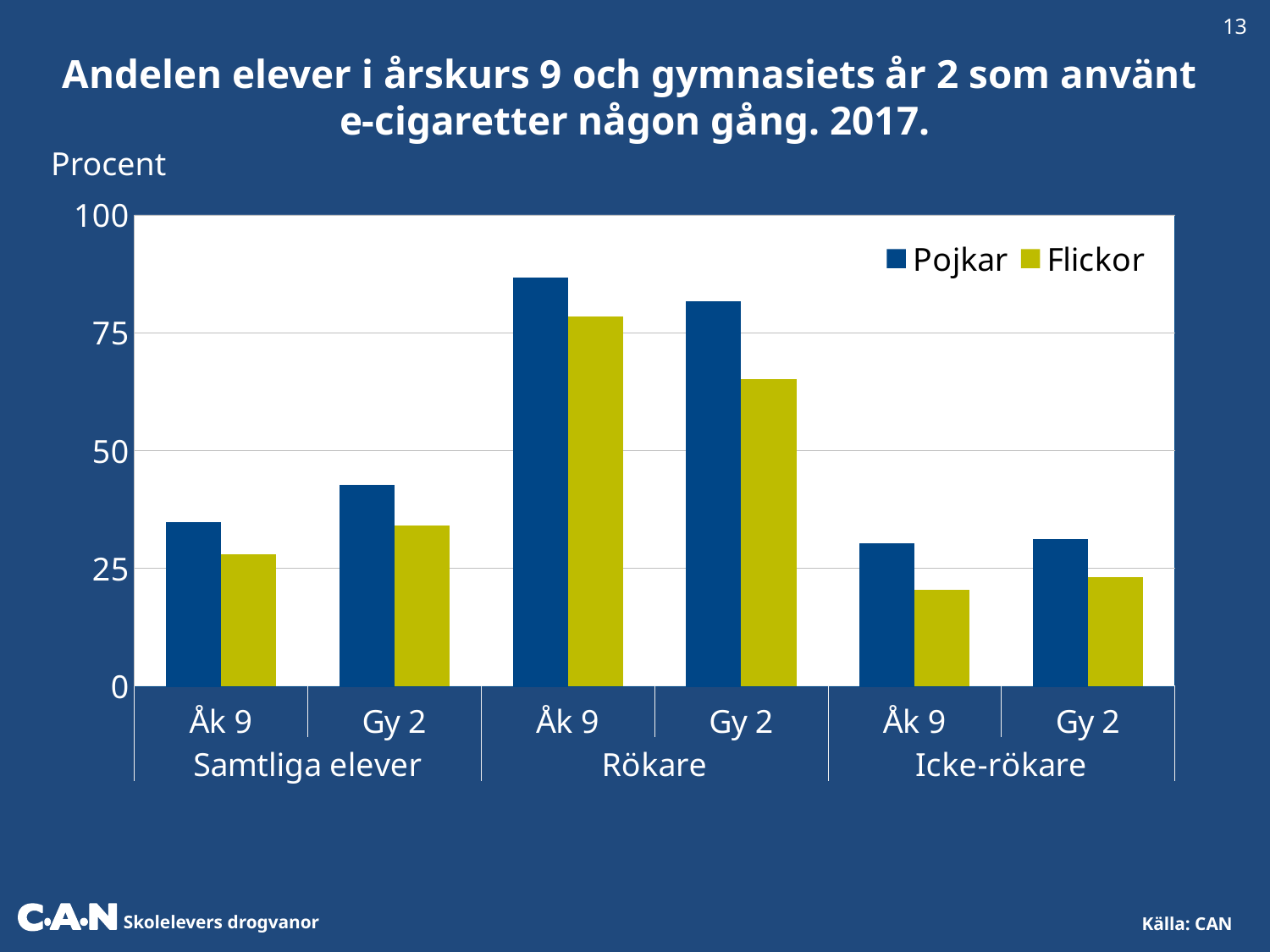
Is the Flickor value for Samtliga elever Åk 9 greater or less than 50? less What kind of chart is shown on the slide? bar chart What is the label on the y axis of the chart? Procent How many bars are plotted in total on the chart? 12 Which is larger for Rökare Gy 2: the Pojkar value or the Flickor value? Pojkar Is the Flickor value for Rökare Gy 2 greater or less than 50? greater How many series does the legend list? 2 Which group and grade has the highest Pojkar value? Rökare, Åk 9 Which group and grade has the lowest Flickor value? Icke-rökare, Åk 9 How many main groups are shown on the x axis? 3 Is the Pojkar value for Rökare Åk 9 greater or less than 75? greater What are the two series named in the legend? Pojkar and Flickor